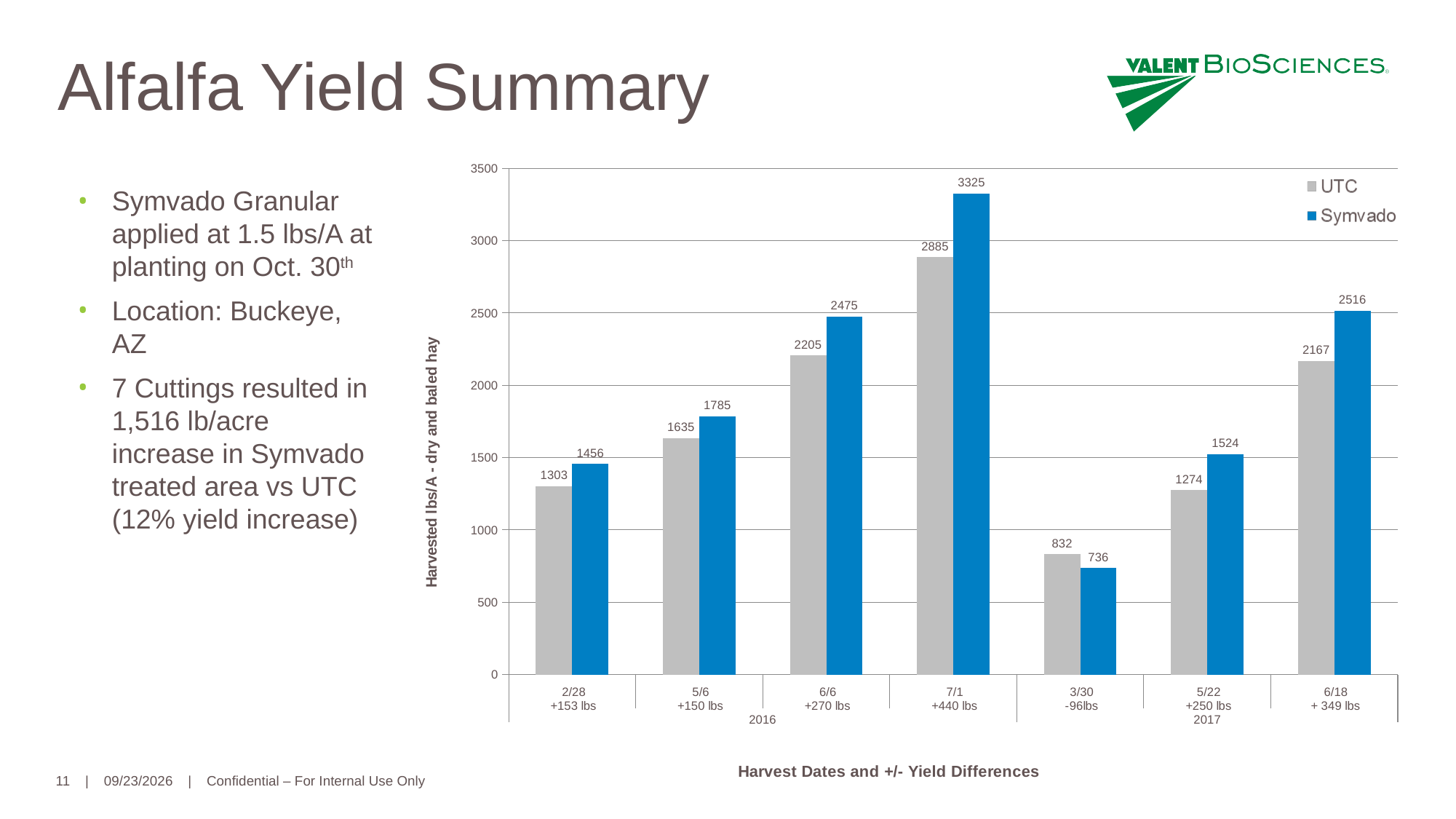
Which harvest date has the highest Symvado value? 7/1 What is the UTC value for the 5/22 harvest date? 1274 Is the UTC value for the 6/6 harvest date greater or less than 2000? greater What is the Symvado value for the 7/1 harvest date? 3325 Which harvest date has the lowest UTC value? 3/30 Which colour represents the Symvado series in the chart? blue How many harvest dates are shown on the x axis? 7 What is the y-axis label of the chart? Harvested lbs/A - dry and baled hay What kind of chart is shown on the slide? bar chart How many series does the legend list? 2 For the 3/30 harvest date, which is larger, the UTC value or the Symvado value? UTC What is the difference between the Symvado and UTC values for the 6/18 harvest date? 349